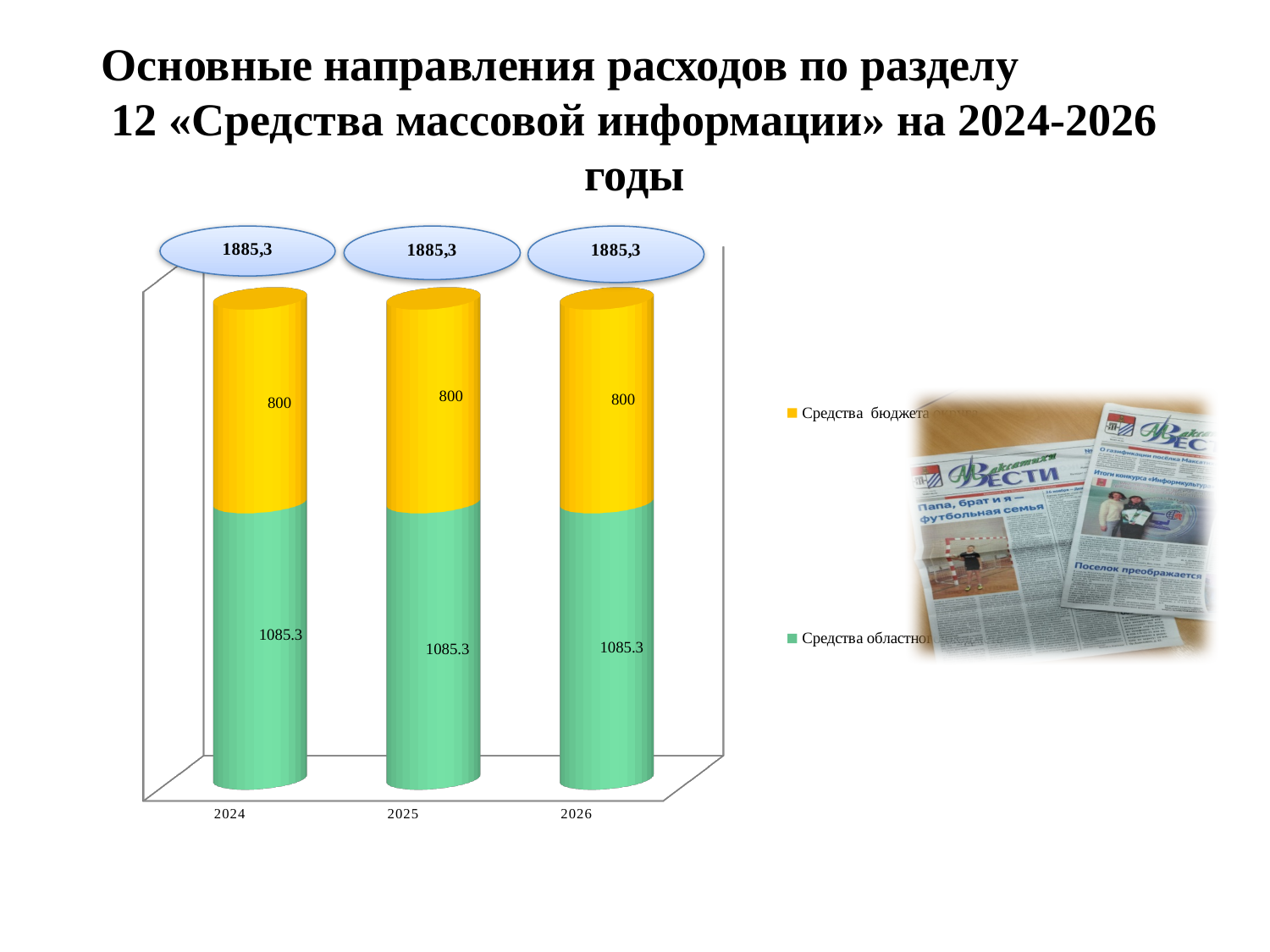
What is the difference between the green and yellow segments in 2024? 285.3 How many years (categories) are shown on the x axis? 3 What kind of chart is shown on the slide? Stacked bar chart What is the value of the green segment for 2025? 1085.3 What is the total shown above the 2024 bar? 1885,3 In 2026, which segment is larger: the green one or the yellow one? The green one (1085.3) How many series does the legend list? 2 What is the value of the green segment for 2026? 1085.3 Do the total values rise, fall or stay the same from 2024 to 2026? Stay the same What is the value of the yellow segment for 2024? 800 Which colour represents the series "Средства бюджета округа" in the legend? Yellow What is the total shown above the 2026 bar? 1885,3